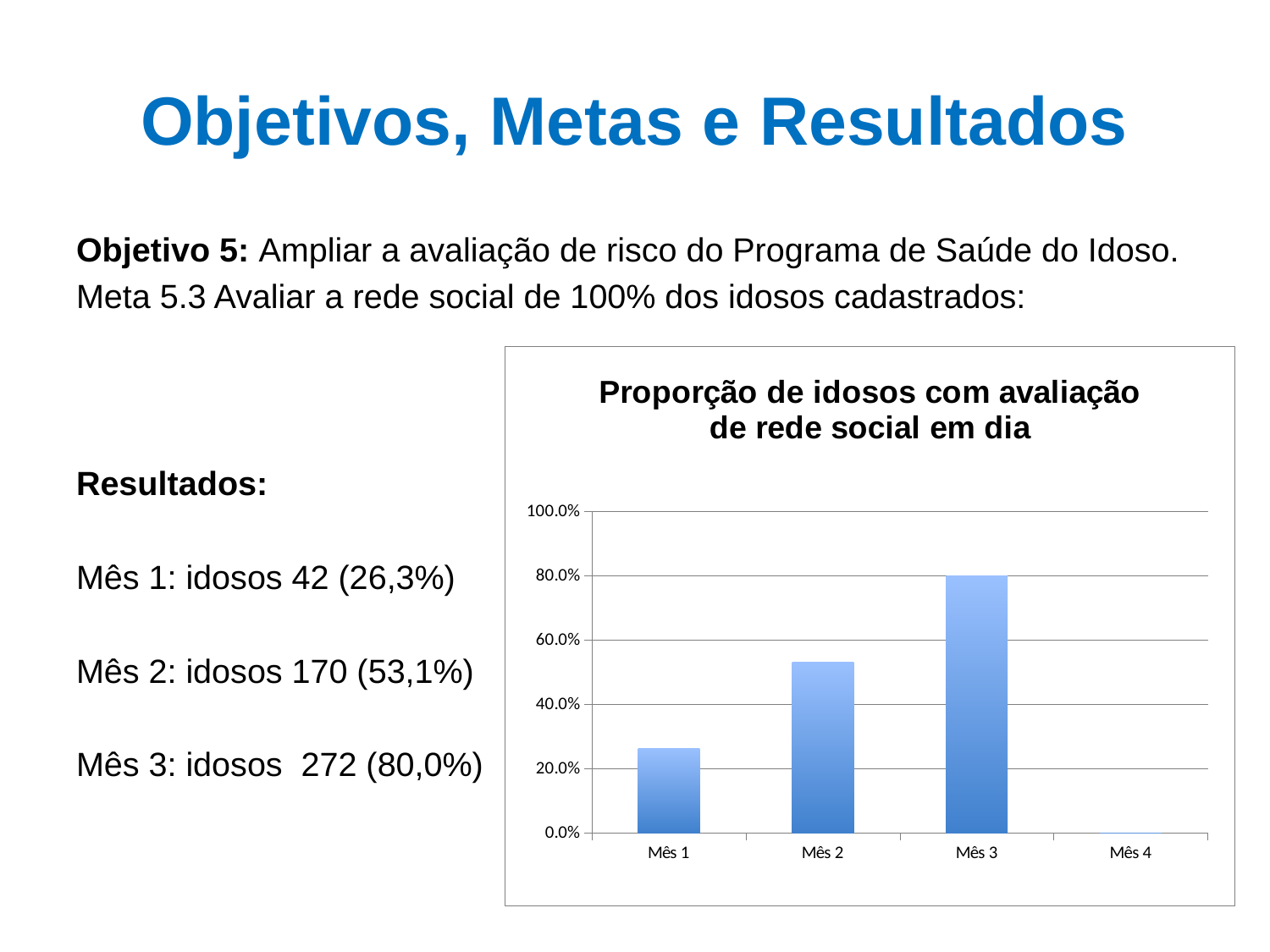
How many categories (months) are shown on the x axis of the chart? 4 Which month has the highest bar in the chart? Mês 3 Do the values rise or fall from Mês 1 to Mês 3? rise What is the title of the chart? Proporção de idosos com avaliação de rede social em dia According to the slide, what proportion was reached in Mês 2? 53,1% What type of chart is shown on the slide? bar chart Is the value for Mês 1 greater or less than 40.0%? less Which month has the lowest bar in the chart? Mês 4 Is the value for Mês 2 greater or less than 40.0%? greater Which is larger, the value for Mês 2 or the value for Mês 3? Mês 3 What is the value for Mês 3 in the chart? 80.0% According to the slide, what proportion was reached in Mês 1? 26,3%